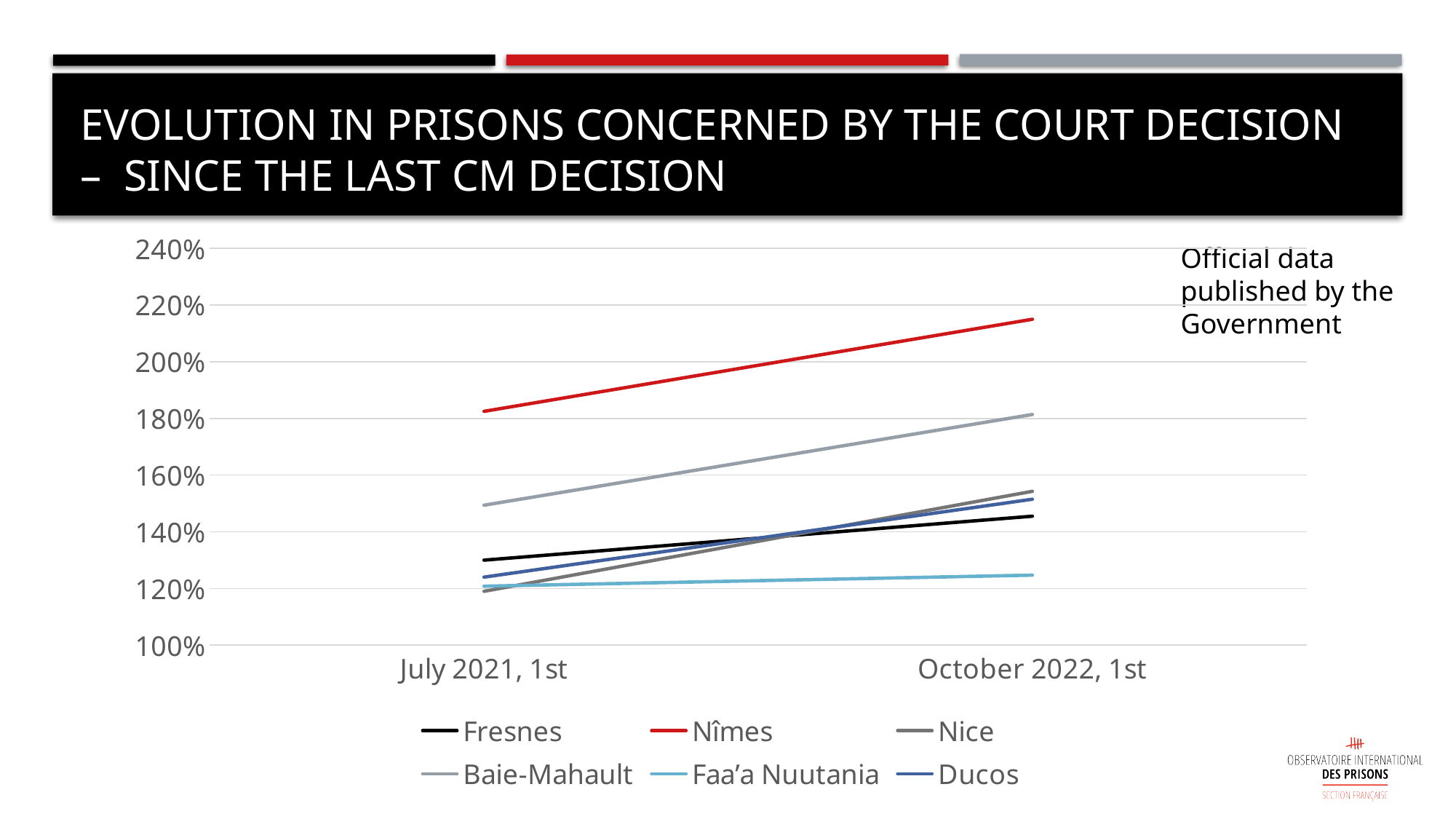
Is the value for Nîmes at October 2022, 1st greater or less than 200%? greater What colour is the line for Nîmes? red Which prison has the highest value at July 2021, 1st? Nîmes Which prison has the lowest value at October 2022, 1st? Faa'a Nuutania Which prison has the highest value at October 2022, 1st? Nîmes Is the value for Fresnes at October 2022, 1st greater or less than 160%? less What kind of chart is shown on the slide? line chart At October 2022, 1st, which is larger: the value for Fresnes or the value for Baie-Mahault? Baie-Mahault How many points are there along the x axis? 2 How many series does the legend list? 6 Does the value for Nîmes rise or fall from July 2021, 1st to October 2022, 1st? rise Is the value for Baie-Mahault at July 2021, 1st greater or less than 160%? less